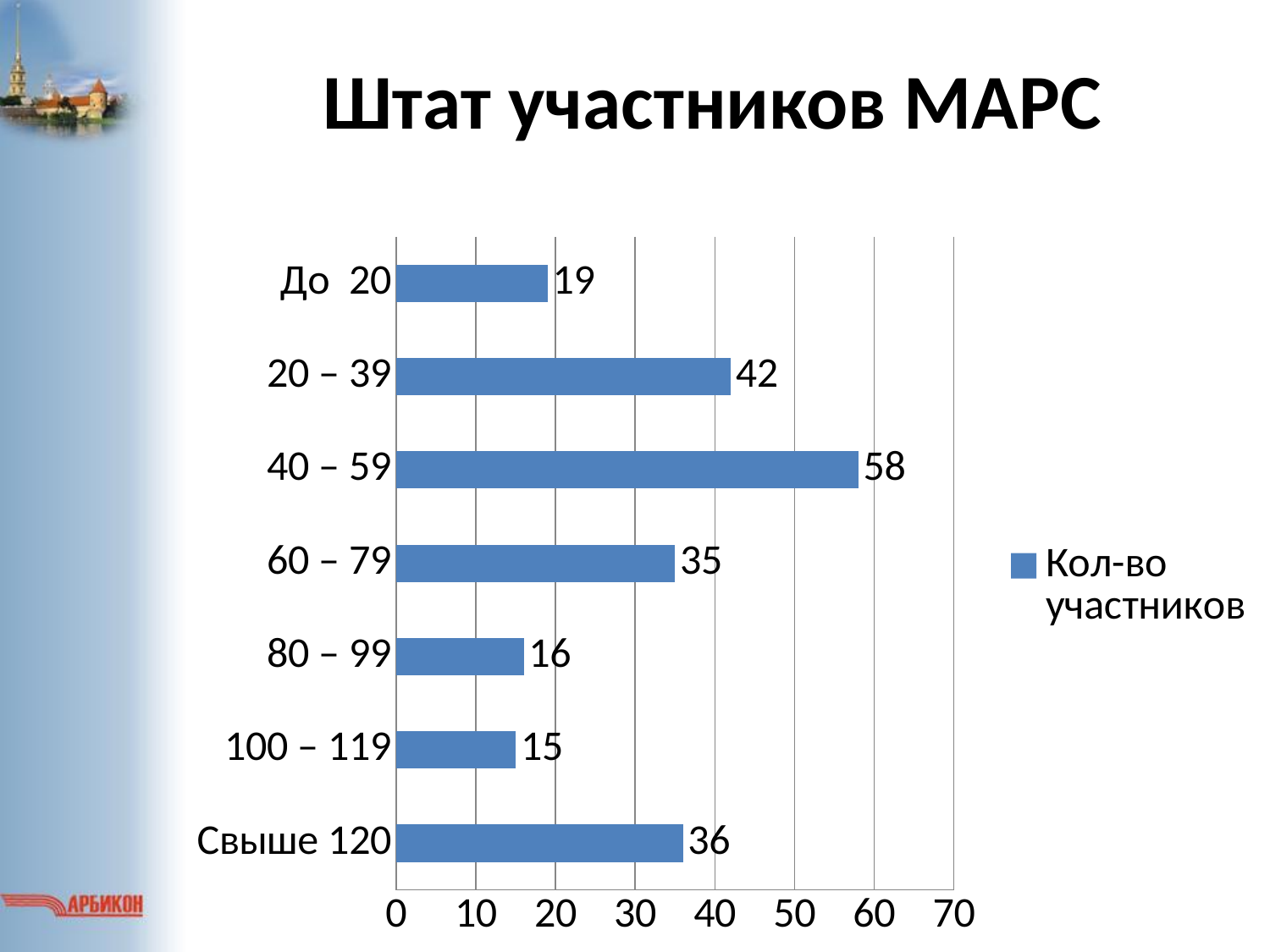
Is the value for "20 – 39" greater or less than 40? greater What is the value for the category "До 20"? 19 Which category has the lowest value? 100 – 119 What is the difference between the values for "40 – 59" and "20 – 39"? 16 What is the value for the category "40 – 59"? 58 How many categories are shown in the chart? 7 What is the value for the category "Свыше 120"? 36 Which is larger, the value for "60 – 79" or the value for "Свыше 120"? Свыше 120 What kind of chart is shown on the slide? bar chart Which category has the highest value? 40 – 59 What is the title of the chart on the slide? Штат участников МАРС How many series does the legend list? 1